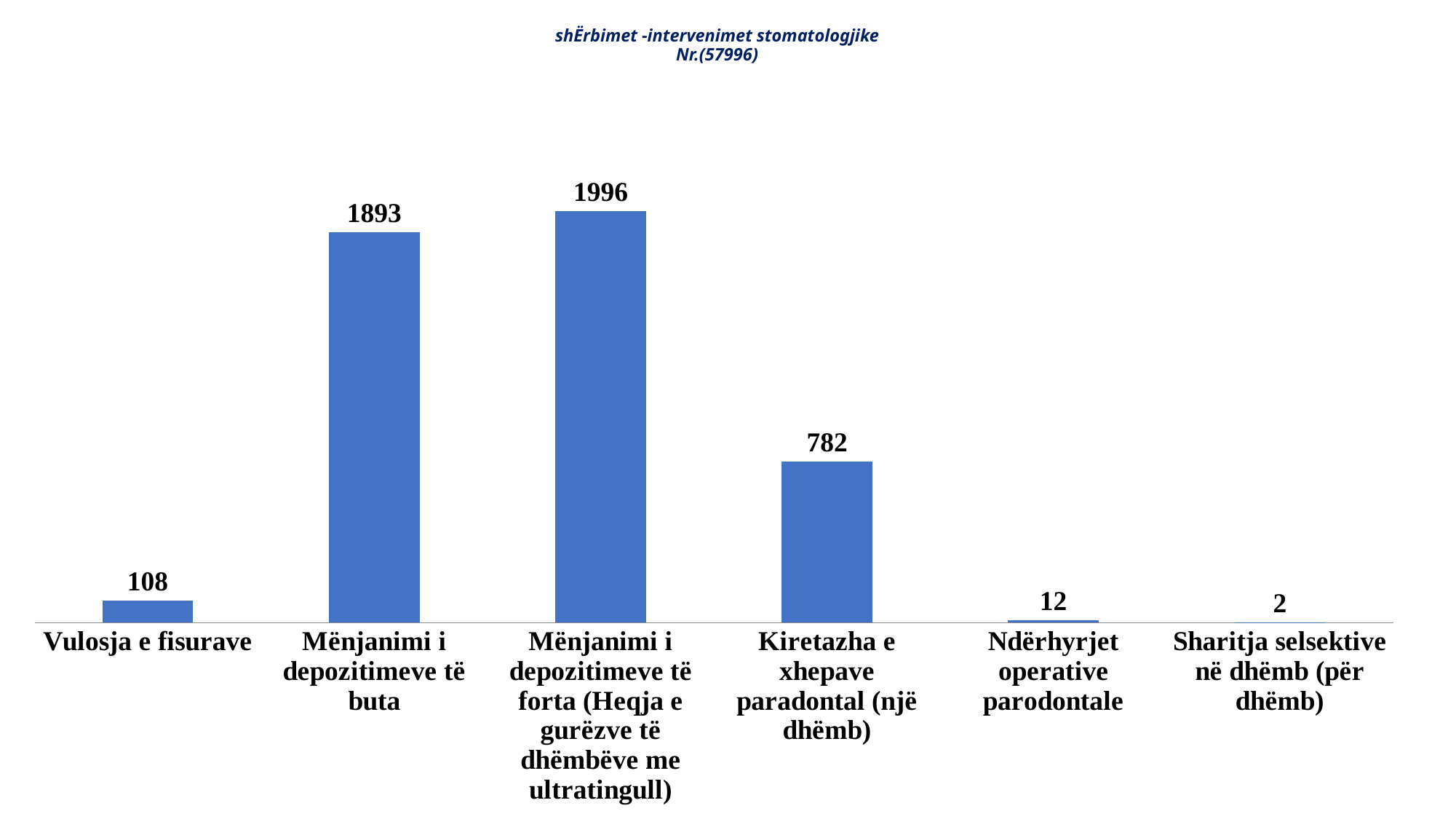
What is the title of the chart? shËrbimet -intervenimet stomatologjike Nr.(57996) What is the value for Ndërhyrjet operative parodontale? 12 Which category has the highest value? Mënjanimi i depozitimeve të forta (Heqja e gurëzve të dhëmbëve me ultratingull) What is the difference between the values for Mënjanimi i depozitimeve të forta and Mënjanimi i depozitimeve të buta? 103 Which category has the lowest value? Sharitja selsektive në dhëmb (për dhëmb) What is the value for Mënjanimi i depozitimeve të buta? 1893 Which is larger, the value for Kiretazha e xhepave paradontal (një dhëmb) or the value for Vulosja e fisurave? Kiretazha e xhepave paradontal (një dhëmb) How many categories are shown in the chart? 6 What is the value for Sharitja selsektive në dhëmb (për dhëmb)? 2 What is the value for Kiretazha e xhepave paradontal (një dhëmb)? 782 What kind of chart is shown on the slide? Bar chart What is the value for Vulosja e fisurave? 108